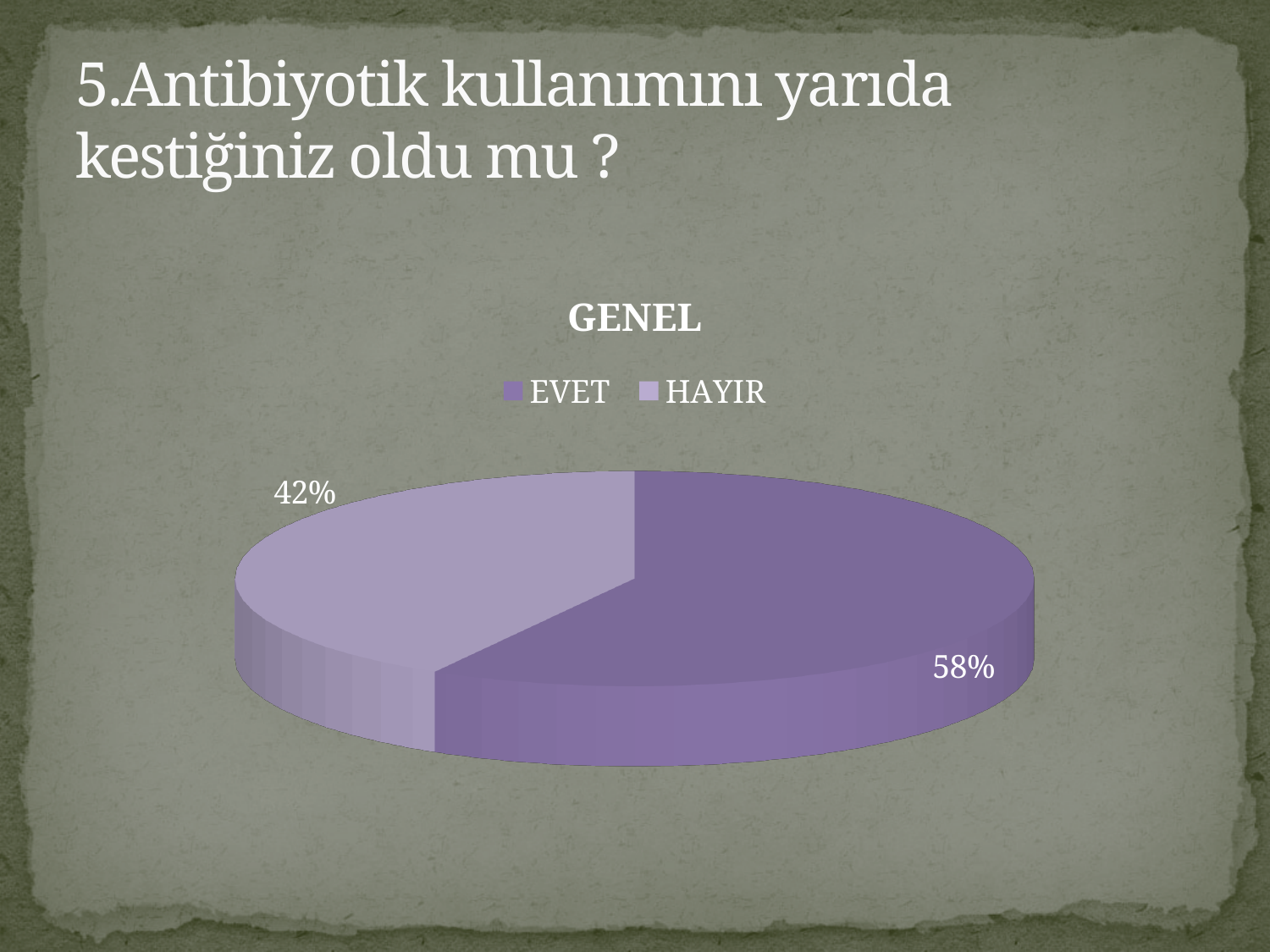
What is the difference in percentage points between the EVET and HAYIR slices? 16 How many slices does the pie chart have? 2 What is the title of the chart? GENEL Which slice is the smallest in the pie chart? HAYIR What percentage of the pie is labelled EVET? 58% What share of the pie does the HAYIR slice represent? 42% Which slice is the largest in the pie chart? EVET Which is larger, the EVET slice or the HAYIR slice? EVET How many entries does the legend list? 2 What percentage of the pie is labelled HAYIR? 42% What type of chart is shown on the slide? pie chart Is the value for EVET greater or less than 50%? greater